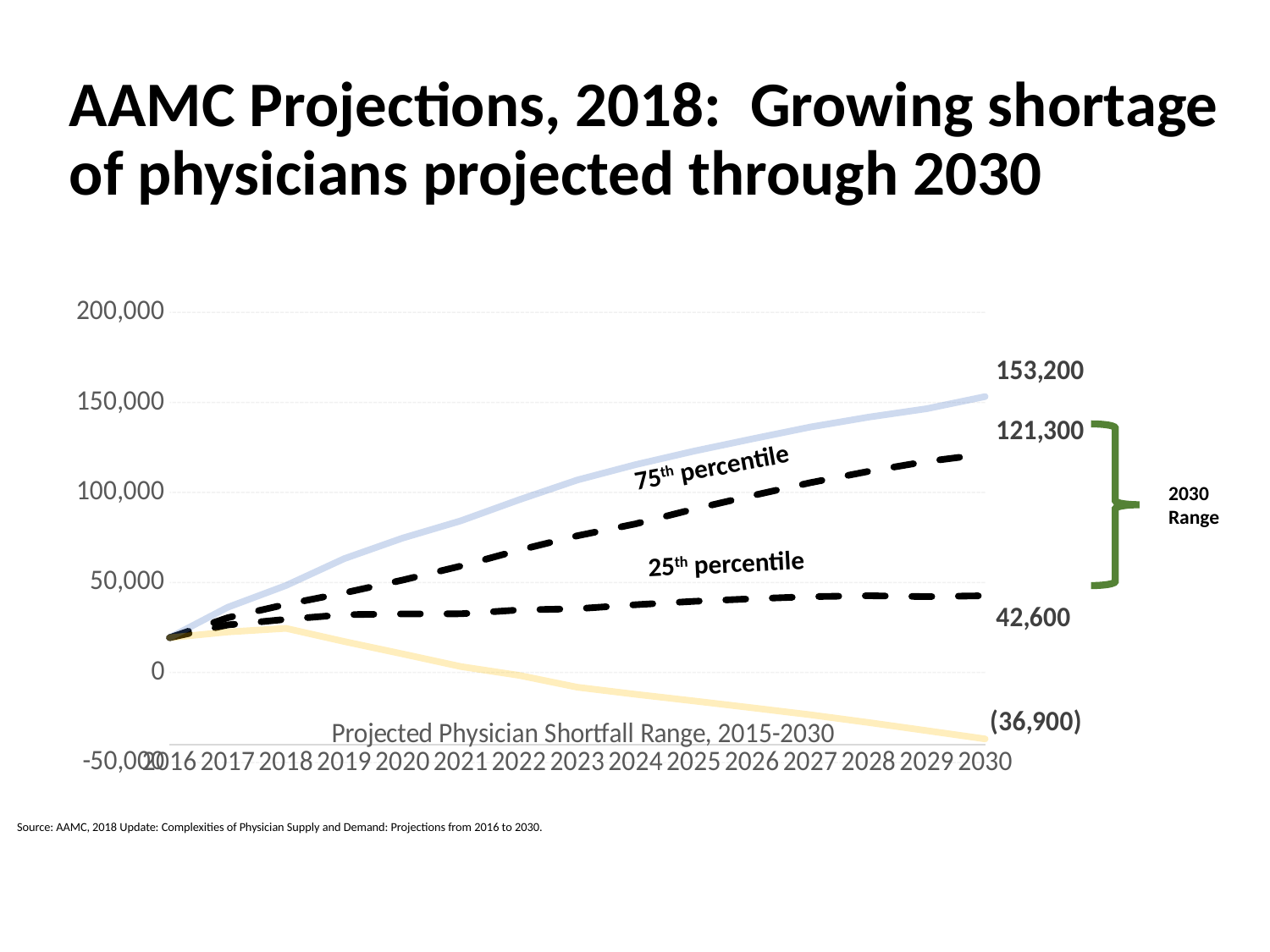
In 2030, which is larger: the 75th percentile or the 25th percentile value? 75th percentile What is the highest value labelled for 2030 on the chart? 153,200 What kind of chart is shown on the slide? line chart What is the lowest value labelled for 2030 on the chart? (36,900) What is the 2030 value of the 25th percentile line? 42,600 Is the 25th percentile value in 2030 greater or less than 50,000? less Is the 75th percentile value in 2030 greater or less than 100,000? greater What is the difference between the top labelled 2030 value (153,200) and the 75th percentile 2030 value? 31,900 What is the 2030 value of the 75th percentile line? 121,300 What is the difference between the 75th percentile and 25th percentile values in 2030? 78,700 Does the 75th percentile line rise or fall from 2016 to 2030? rise What is the title shown on the chart? Projected Physician Shortfall Range, 2015-2030